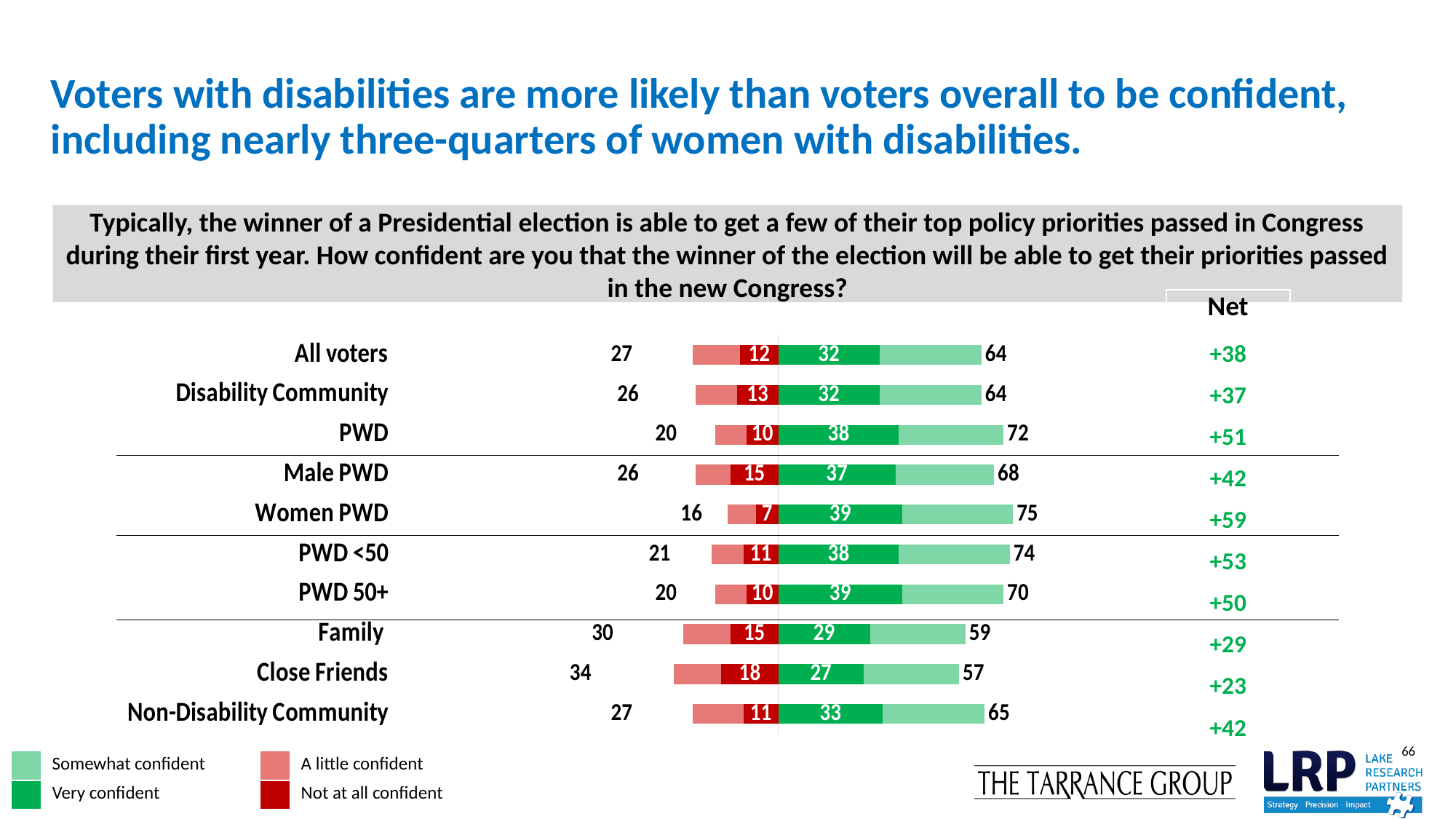
What kind of chart is shown on the slide? Stacked bar chart What is the difference between the total confident percentages for Women PWD and Male PWD? 7 How many groups are shown in the chart? 10 What is the 'Not at all confident' value for Close Friends? 18 What percentage of Women PWD are confident (somewhat or very) in total? 75 Which group has the lowest total confident percentage? Close Friends What is the 'Very confident' value for PWD? 38 How many response categories does the legend list? 4 Which group has the lowest Net value? Close Friends Which has a higher total confident percentage, Family or Non-Disability Community? Non-Disability Community What is the Net value shown for PWD <50? +53 Which group has the highest total confident percentage? Women PWD